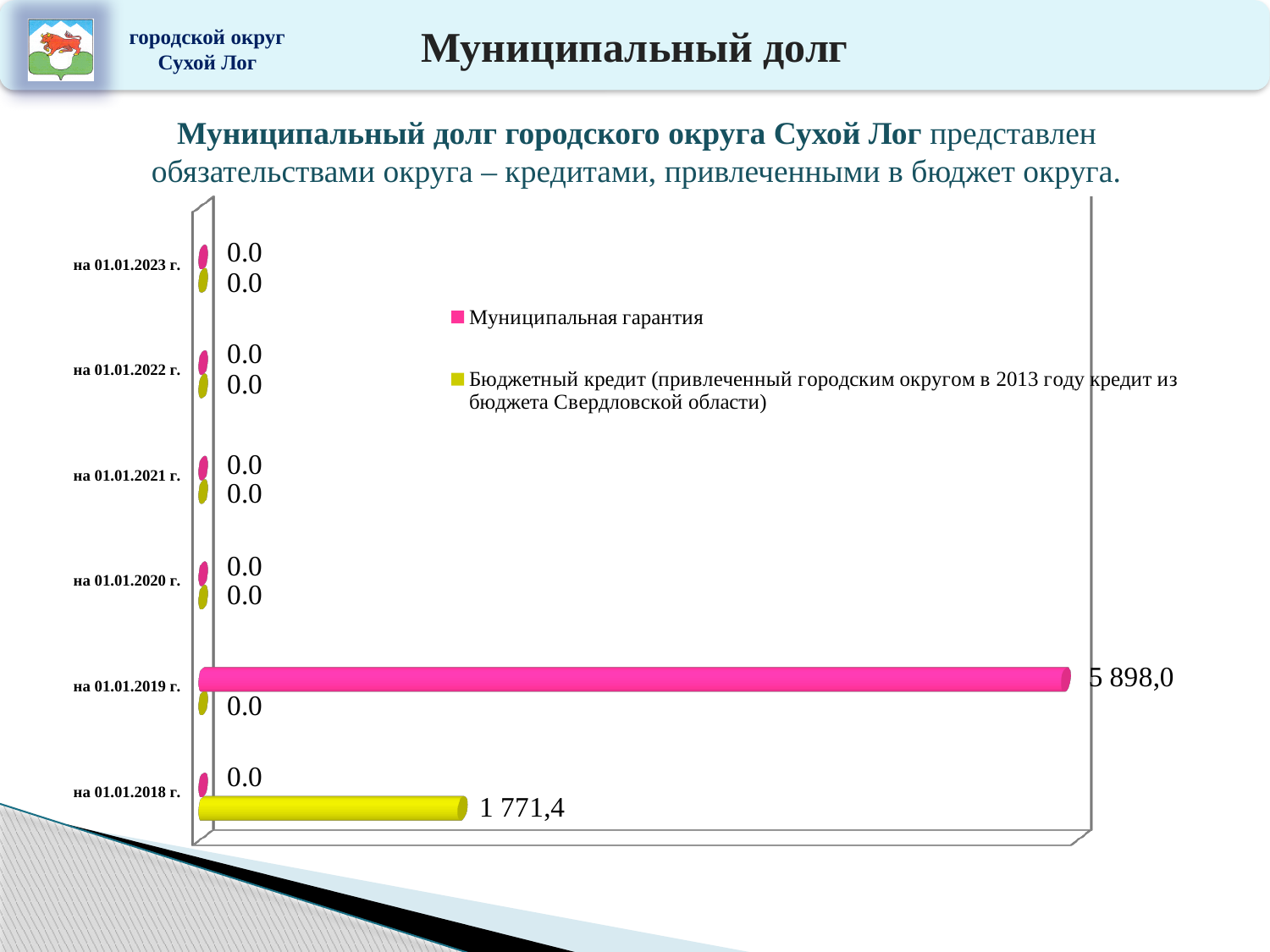
On which date does Муниципальная гарантия reach its highest value? на 01.01.2019 г. What kind of chart is shown on the slide? bar chart What is the value of Муниципальная гарантия на 01.01.2018 г.? 0.0 What is the value of Бюджетный кредит на 01.01.2023 г.? 0.0 What is the value of Бюджетный кредит на 01.01.2018 г.? 1 771,4 On which date does Бюджетный кредит reach its highest value? на 01.01.2018 г. What is the value of Бюджетный кредит на 01.01.2019 г.? 0.0 How many date categories are shown on the chart? 6 What is the difference between Муниципальная гарантия на 01.01.2019 г. and Бюджетный кредит на 01.01.2018 г.? 4 126,6 Which is larger: Муниципальная гарантия на 01.01.2019 г. or Бюджетный кредит на 01.01.2018 г.? Муниципальная гарантия на 01.01.2019 г. How many series does the chart legend list? 2 What is the value of Муниципальная гарантия на 01.01.2019 г.? 5 898,0